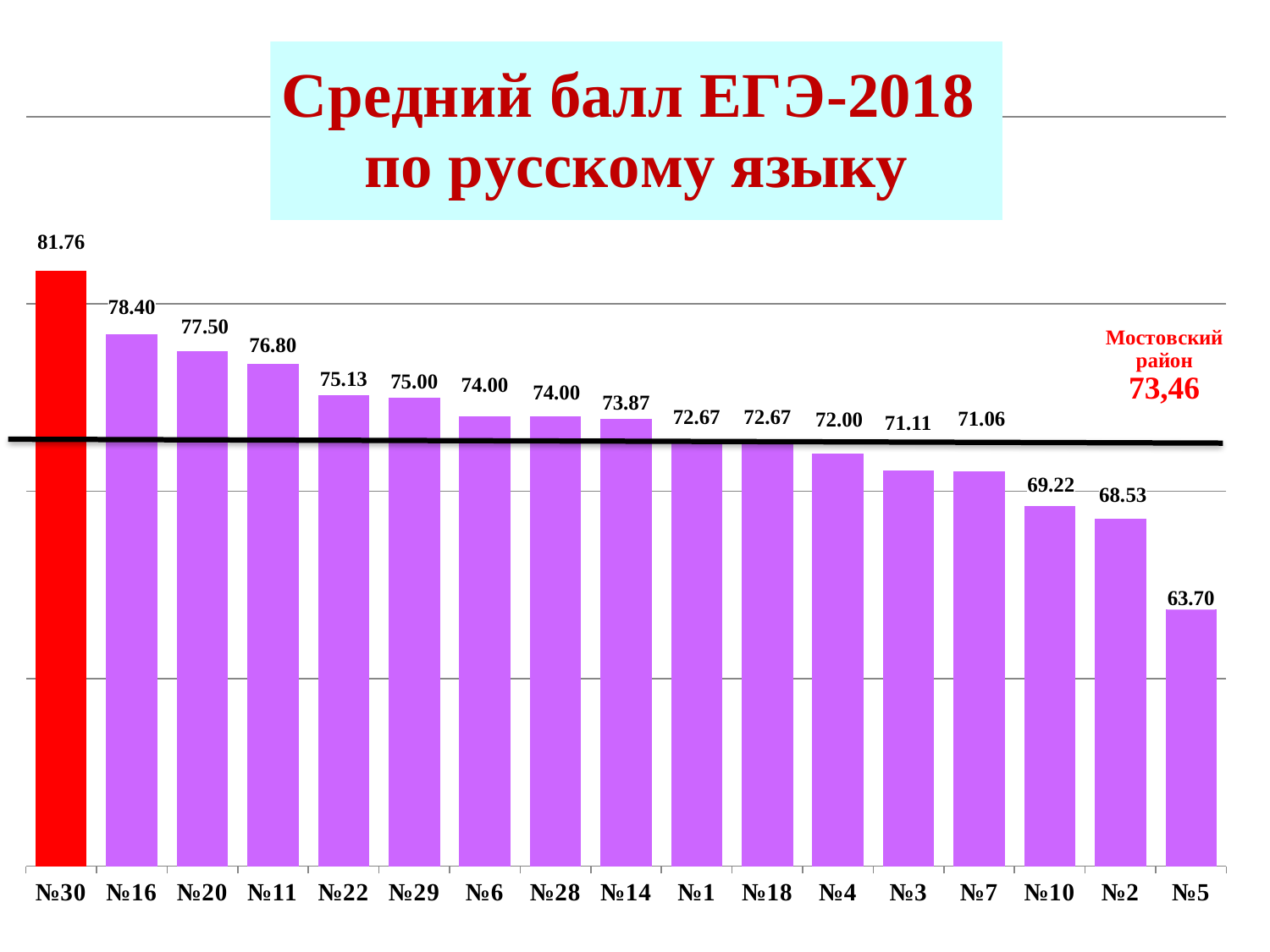
What is the difference between the scores of school №2 and school №5? 4.83 What is the difference between the scores of school №30 and school №16? 3.36 What type of chart is shown on the slide? Bar chart Which school has the highest average score? №30 What is the average score for the Мостовский район shown on the chart? 73,46 How many schools are shown on the chart? 17 Which has a higher average score, school №4 or school №7? №4 Which school has the lowest average score? №5 What is the average score for school №22? 75.13 What is the average score for school №10? 69.22 Which has a higher average score, school №20 or school №11? №20 What is the average score for school №30? 81.76